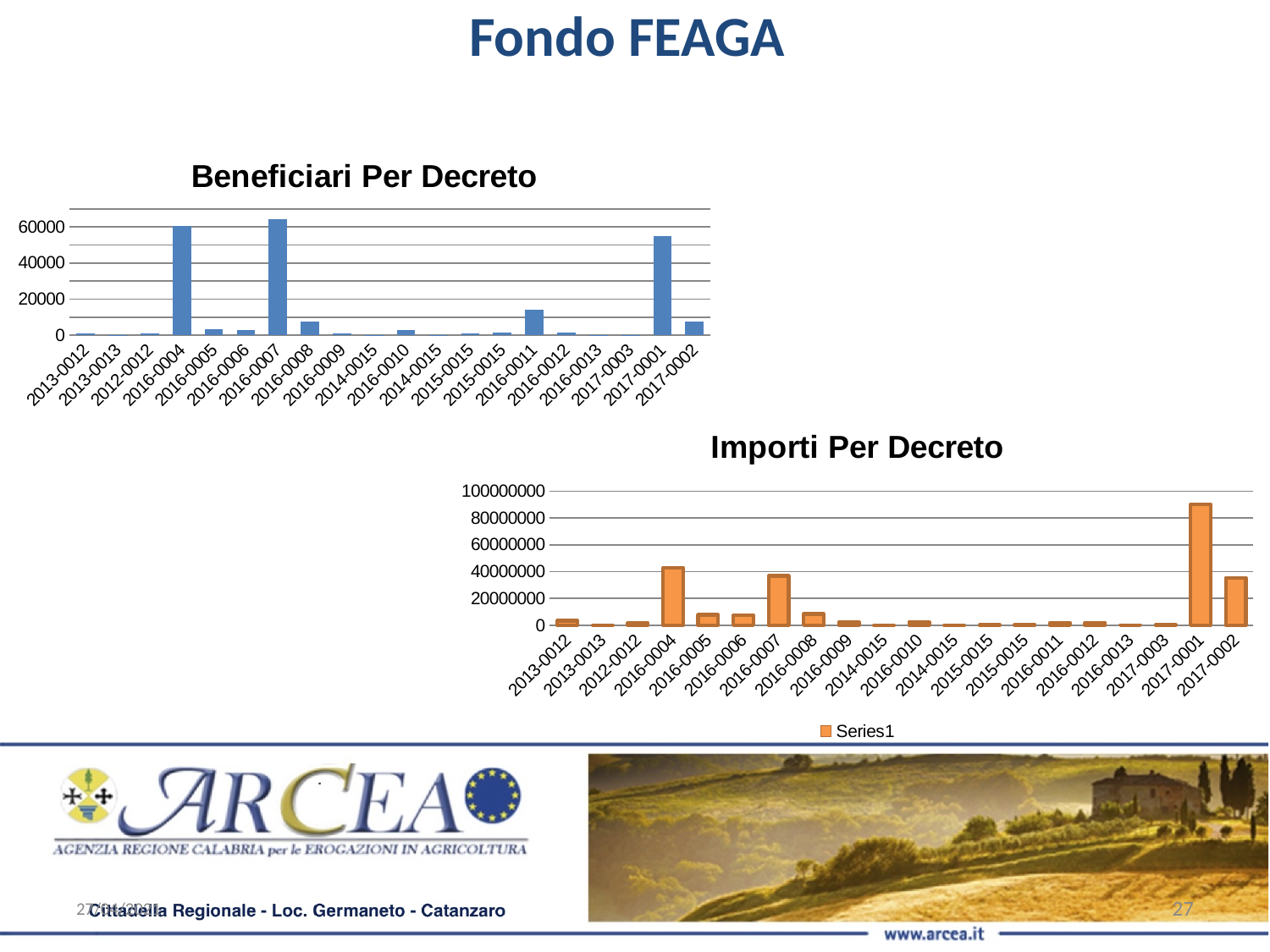
In the 'Importi Per Decreto' chart, is the value for 2017-0001 greater or less than 80000000? greater In the 'Importi Per Decreto' chart, is the value for 2017-0002 greater or less than 40000000? less In the 'Importi Per Decreto' chart, which decree has the highest amount? 2017-0001 In the 'Importi Per Decreto' chart, which is larger, the value for 2016-0004 or the value for 2016-0005? 2016-0004 In the 'Beneficiari Per Decreto' chart, is the value for 2016-0011 greater or less than 20000? less How many decree categories are shown on the x axis of the 'Importi Per Decreto' chart? 20 In the 'Beneficiari Per Decreto' chart, which is larger, the value for 2016-0004 or the value for 2017-0001? 2016-0004 In the 'Beneficiari Per Decreto' chart, which decree has the highest number of beneficiaries? 2016-0007 What kind of chart is 'Beneficiari Per Decreto'? Bar chart What series name is shown in the legend of the 'Importi Per Decreto' chart? Series1